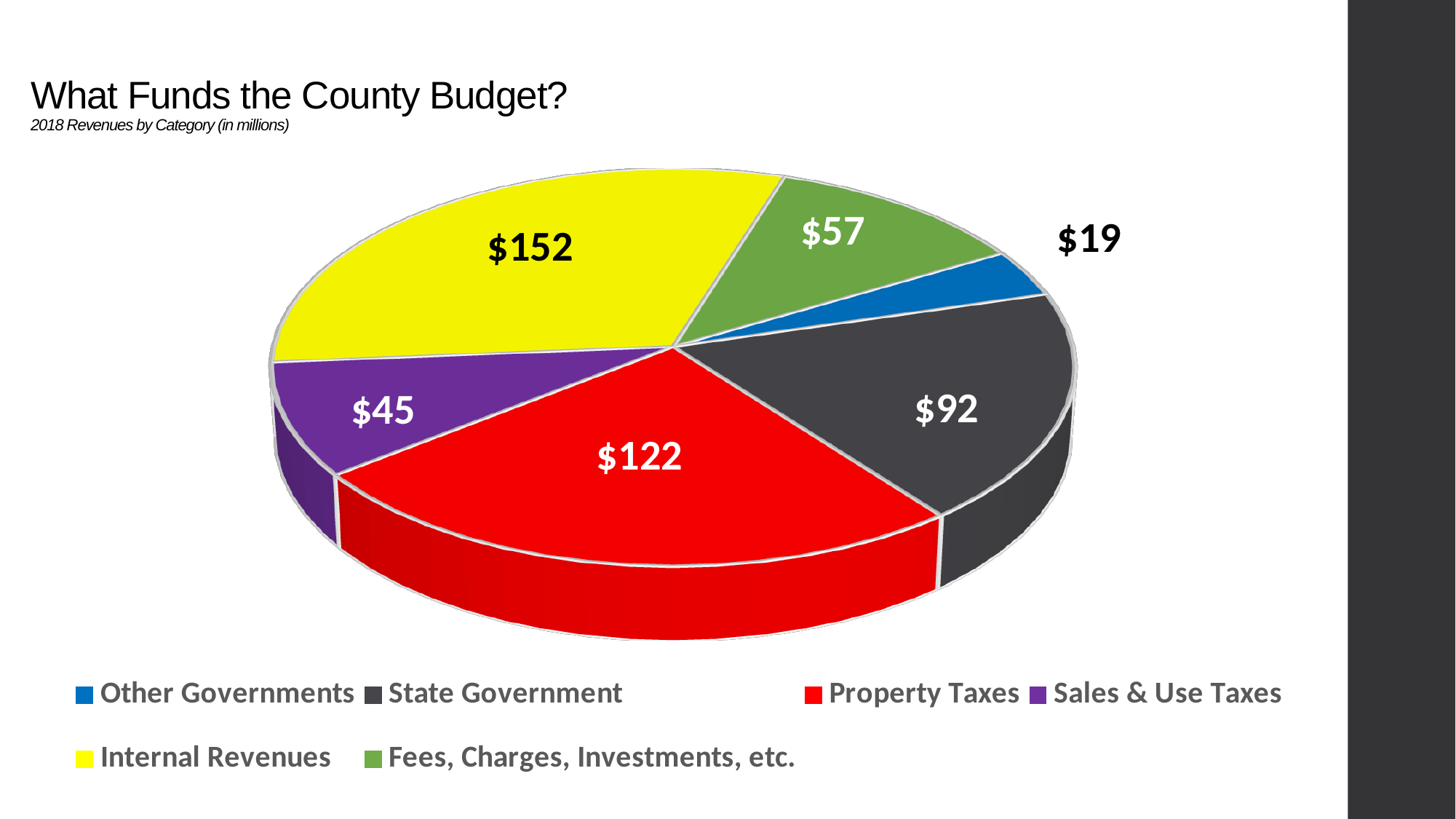
How many categories does the pie chart show? 6 What colour is the slice for Sales & Use Taxes? purple What is the difference between Internal Revenues and Property Taxes? $30 Which is larger, Fees, Charges, Investments, etc. or Sales & Use Taxes? Fees, Charges, Investments, etc. What is the value for State Government? $92 What is the value for Property Taxes? $122 Which category has the largest slice of the pie? Internal Revenues What kind of chart is shown on the slide? pie chart What is the total of all the values shown in the pie chart? $487 What is the value for Other Governments? $19 Which category has the smallest slice of the pie? Other Governments What is the value for Internal Revenues? $152